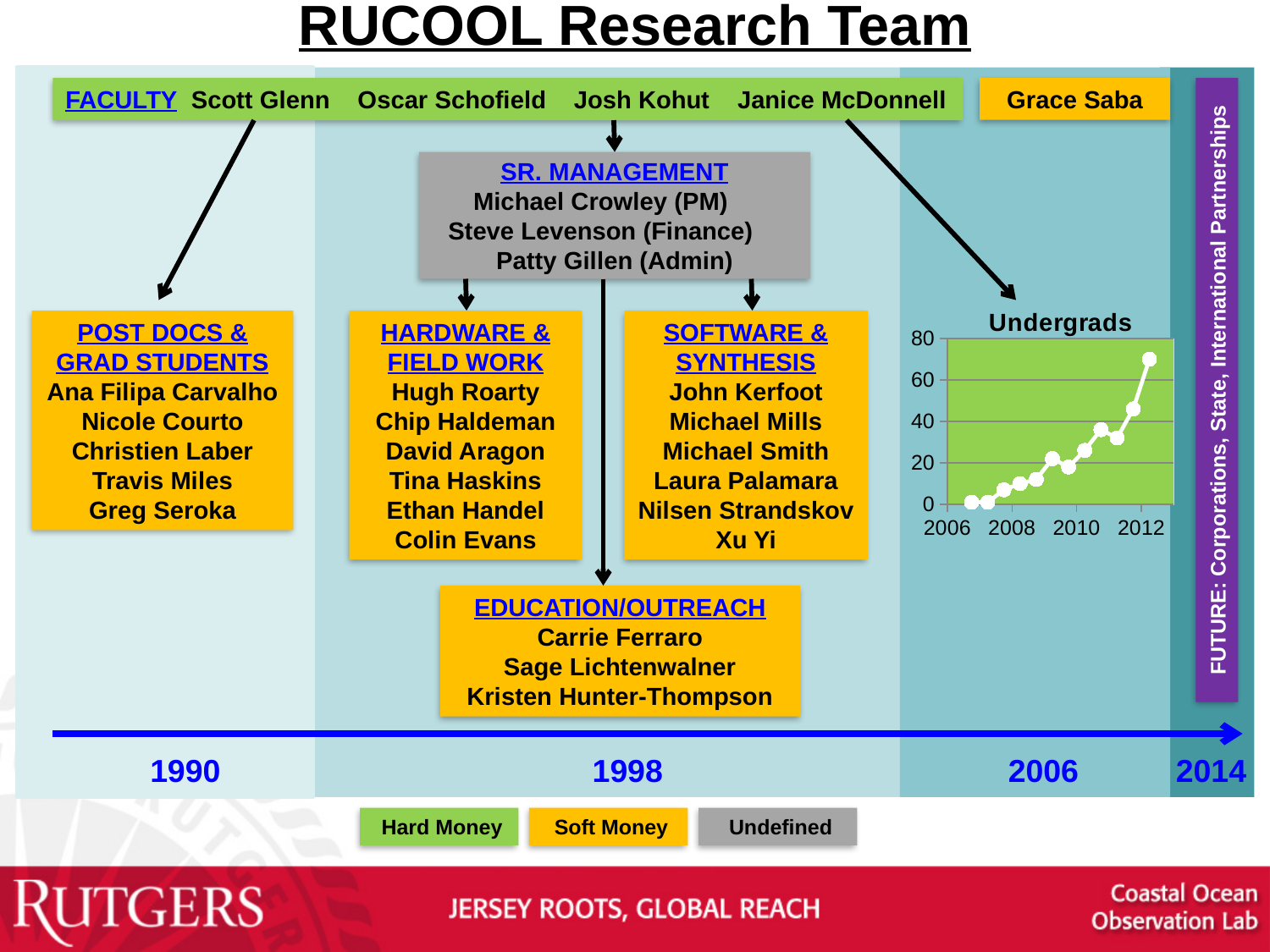
In the Undergrads chart, is the lowest value at the beginning or the end of the series? beginning In the Undergrads chart, which is larger: the value at 2008 or the value at 2012? 2012 In the Undergrads chart, is the value at the first point (around 2006) greater or less than 20? less What kind of chart is shown on the slide? line chart In the Undergrads chart, is the highest value at the beginning or the end of the series? end In the Undergrads chart, is the value at the last point (around 2012) greater or less than 60? greater How many data series are plotted in the Undergrads chart? 1 Do the values in the Undergrads chart rise or fall over time along the x axis? rise What is the title of the chart on the slide? Undergrads In the Undergrads chart, is the value at 2010 greater or less than 40? less What is the maximum value shown on the y axis of the Undergrads chart? 80